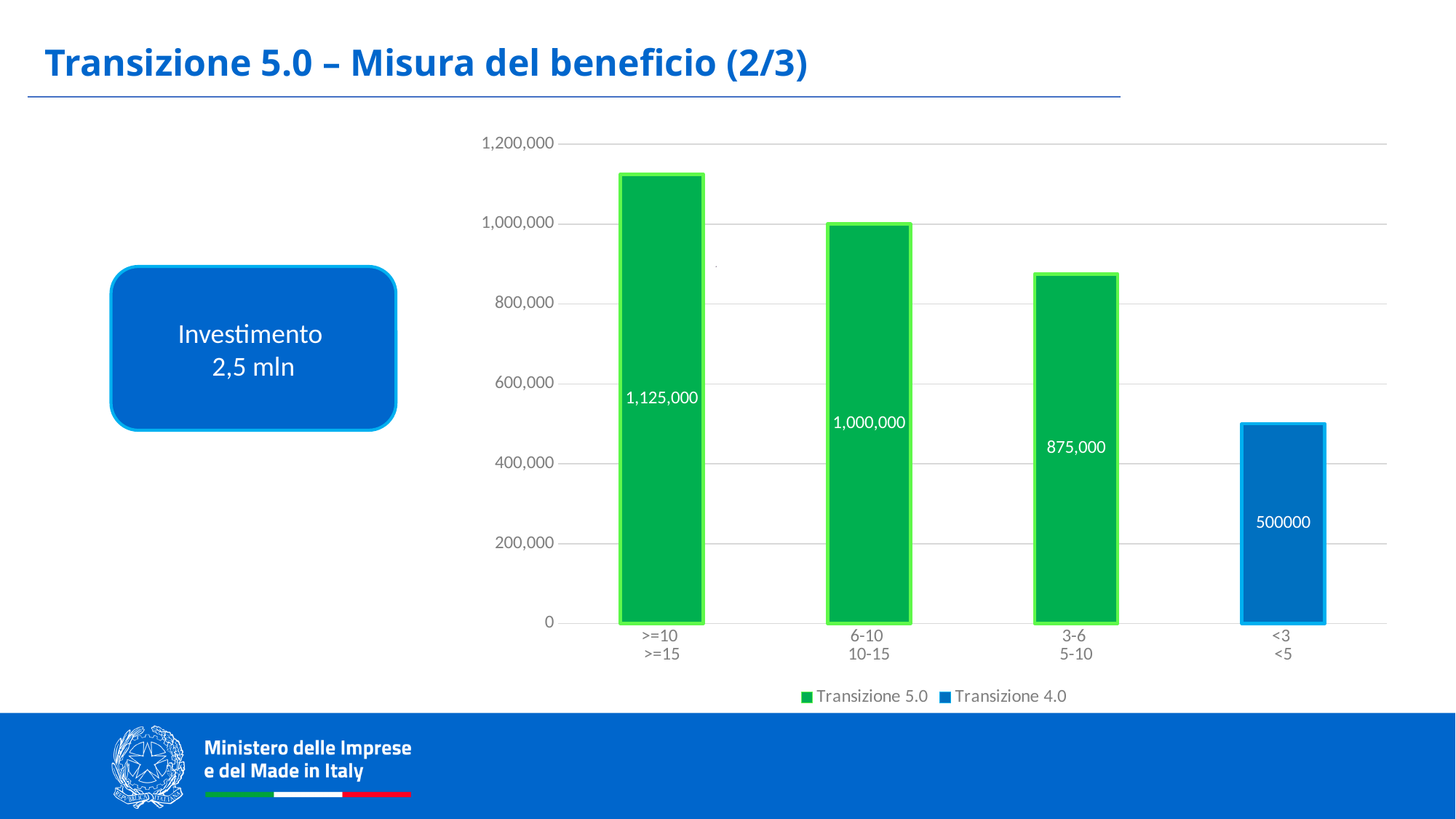
Is the value for '3-6 5-10' greater or less than 800,000? greater What is the value of the bar for the category '>=10 >=15'? 1,125,000 Which category has the lowest bar? <3 <5 What is the value of the bar for the category '6-10 10-15'? 1,000,000 Which category has the highest bar? >=10 >=15 What kind of chart is shown on the slide? Bar chart What is the value of the bar for the category '3-6 5-10'? 875,000 How many bars are shown in the chart? 4 What is the difference between the bar for '>=10 >=15' and the bar for '3-6 5-10'? 250,000 Which is larger, the bar for '6-10 10-15' or the bar for '<3 <5'? 6-10 10-15 What is the value of the bar for the category '<3 <5'? 500000 How many series does the legend list? 2